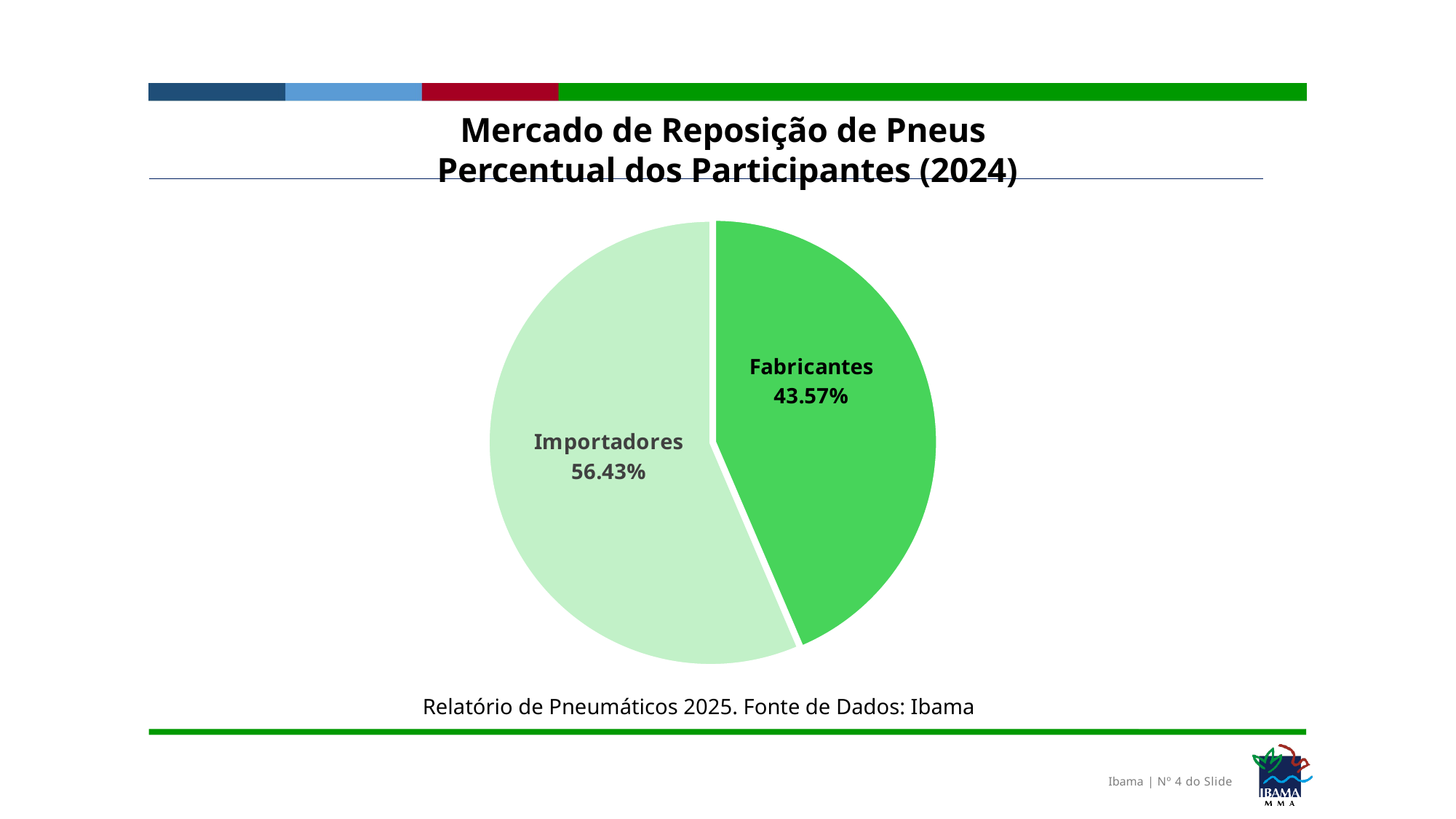
What is the title of the chart? Mercado de Reposição de Pneus Percentual dos Participantes (2024) What percentage of the pie chart is labelled Fabricantes? 43.57% Which slice of the pie chart is shown in the darker green colour? Fabricantes What is the difference in percentage points between the Importadores and Fabricantes slices? 12.86 Which is larger, the Fabricantes slice or the Importadores slice? Importadores What kind of chart is shown on the slide? Pie chart Which slice of the pie chart is the smallest? Fabricantes What percentage of the pie chart is labelled Importadores? 56.43% How many slices does the pie chart have? 2 Which slice of the pie chart is the largest? Importadores What share of the pie does the Importadores slice represent? 56.43%